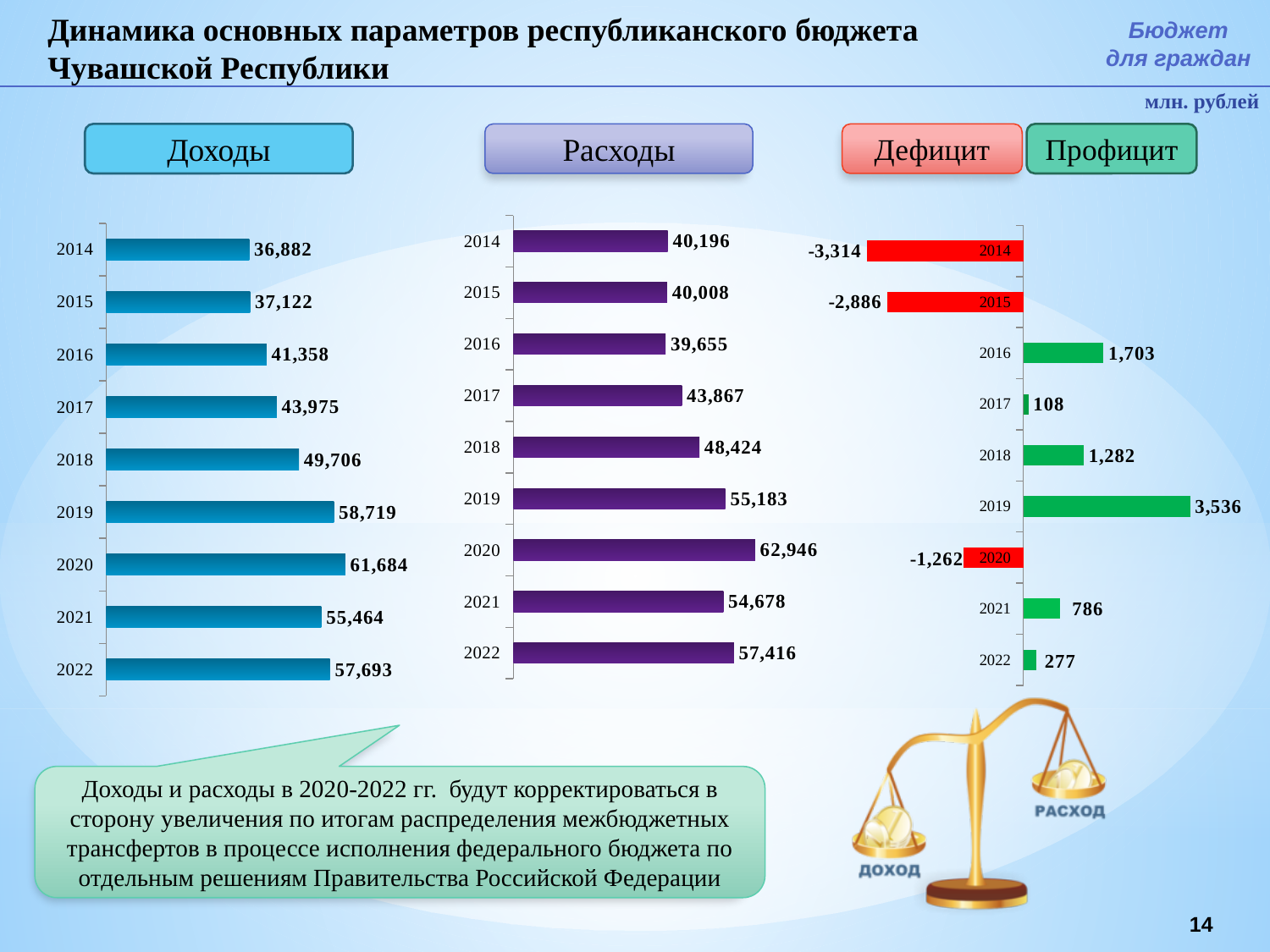
In the Расходы chart, what is the value for 2020? 62,946 In the Доходы chart, what is the difference between the values for 2020 and 2019? 2,965 In the Доходы chart, what is the value for 2018? 49,706 In the Доходы chart, which year has the highest value? 2020 In the Доходы chart, do the values rise or fall from 2014 to 2020? Rise In the Расходы chart, which year has the lowest value? 2016 In the Дефицит/Профицит chart, which year has the largest surplus? 2019 In the Доходы chart, which year has the larger value, 2021 or 2022? 2022 How many years are shown in the Расходы chart? 9 In the Дефицит/Профицит chart, what is the value for 2017? 108 In the Дефицит/Профицит chart, what is the value for 2014? -3,314 What type of chart is the Доходы chart? Bar chart